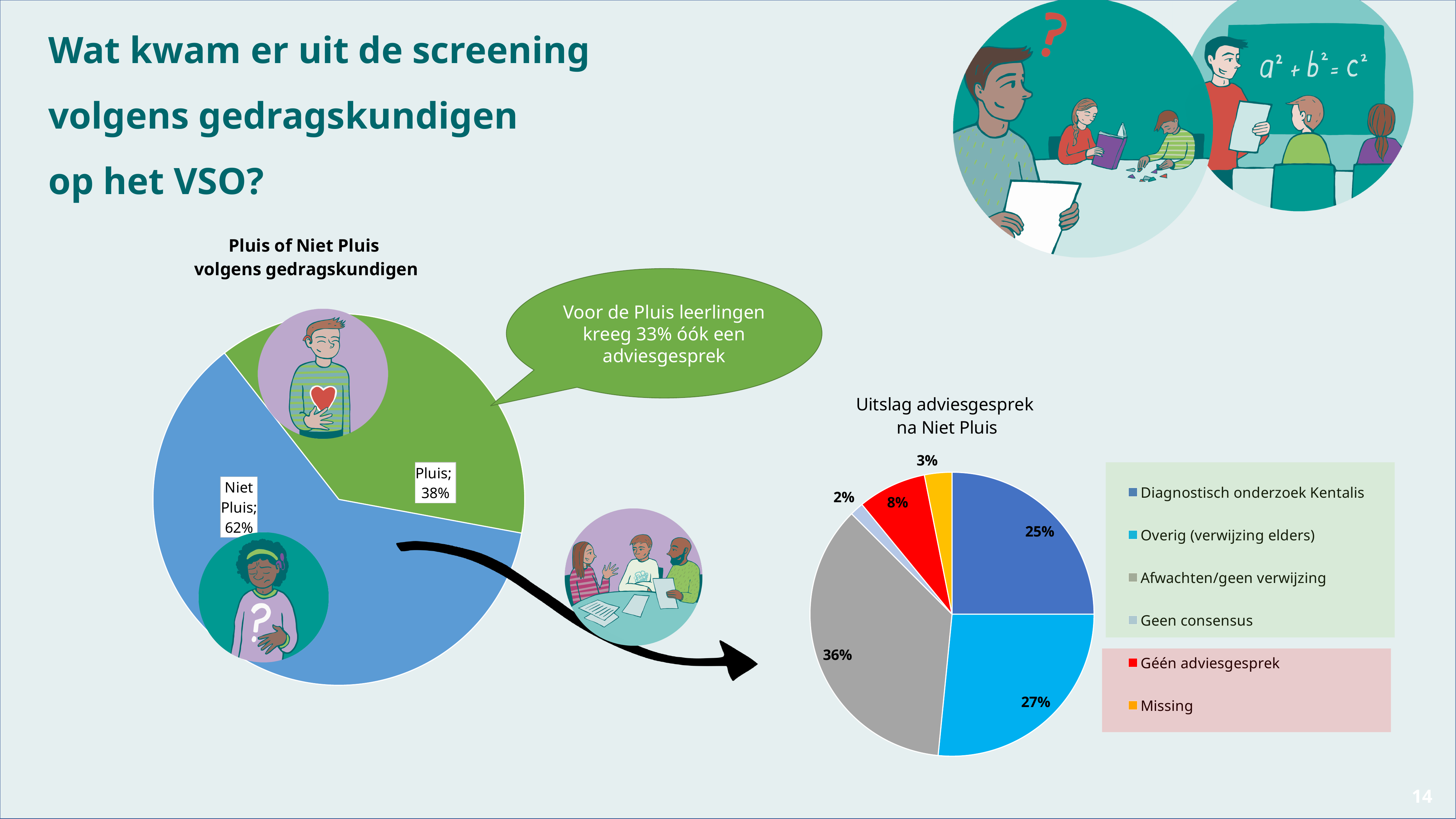
In the chart 'Pluis of Niet Pluis volgens gedragskundigen', what percentage is Pluis? 38% In the chart 'Uitslag adviesgesprek na Niet Pluis', what percentage is Géén adviesgesprek? 8% In the chart 'Uitslag adviesgesprek na Niet Pluis', what percentage is Afwachten/geen verwijzing? 36% In the chart 'Pluis of Niet Pluis volgens gedragskundigen', what is the difference in percentage points between Niet Pluis and Pluis? 24 In the chart 'Uitslag adviesgesprek na Niet Pluis', which category has the smallest share? Geen consensus How many categories does the legend of 'Uitslag adviesgesprek na Niet Pluis' list? 6 In the chart 'Uitslag adviesgesprek na Niet Pluis', which category has the largest share? Afwachten/geen verwijzing In the chart 'Pluis of Niet Pluis volgens gedragskundigen', what percentage is Niet Pluis? 62% In the chart 'Pluis of Niet Pluis volgens gedragskundigen', which slice is larger, Pluis or Niet Pluis? Niet Pluis What kind of chart is 'Uitslag adviesgesprek na Niet Pluis'? Pie chart In the chart 'Uitslag adviesgesprek na Niet Pluis', what percentage is Diagnostisch onderzoek Kentalis? 25% In the chart 'Uitslag adviesgesprek na Niet Pluis', what is the difference in percentage points between Overig (verwijzing elders) and Missing? 24